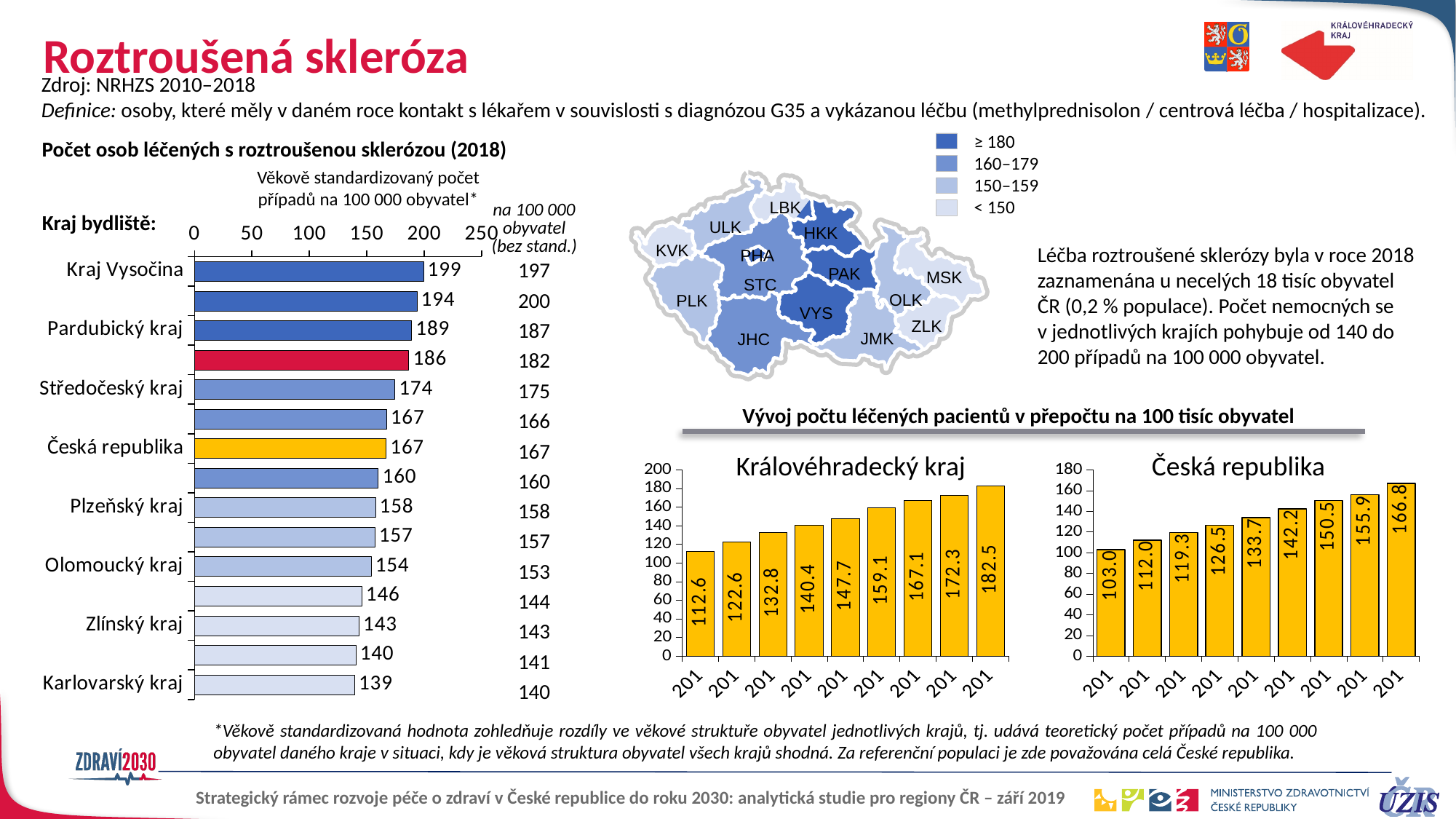
In the chart 'Počet osob léčených s roztroušenou sklerózou (2018)', what is the age-standardised value for Česká republika? 167 In the chart 'Počet osob léčených s roztroušenou sklerózou (2018)', which labelled region has the lowest age-standardised value? Karlovarský kraj How many bars are shown in the 'Královéhradecký kraj' chart? 9 In the 'Královéhradecký kraj' chart, what is the value of the first bar? 112.6 In the chart 'Počet osob léčených s roztroušenou sklerózou (2018)', what is the age-standardised value for Kraj Vysočina? 199 In the chart 'Počet osob léčených s roztroušenou sklerózou (2018)', what is the age-standardised value for Pardubický kraj? 189 In the chart 'Počet osob léčených s roztroušenou sklerózou (2018)', which has the larger age-standardised value, Plzeňský kraj or Olomoucký kraj? Plzeňský kraj In the chart 'Počet osob léčených s roztroušenou sklerózou (2018)', which region has the highest age-standardised value? Kraj Vysočina In the 'Česká republika' time-series chart, do the values rise or fall from left to right? rise In the 'Královéhradecký kraj' chart, what is the value of the last bar? 182.5 In the 'Česká republika' time-series chart, what is the difference between the last bar (166.8) and the first bar (103.0)? 63.8 In the chart 'Počet osob léčených s roztroušenou sklerózou (2018)', what is the difference between the age-standardised values for Kraj Vysočina and Karlovarský kraj? 60